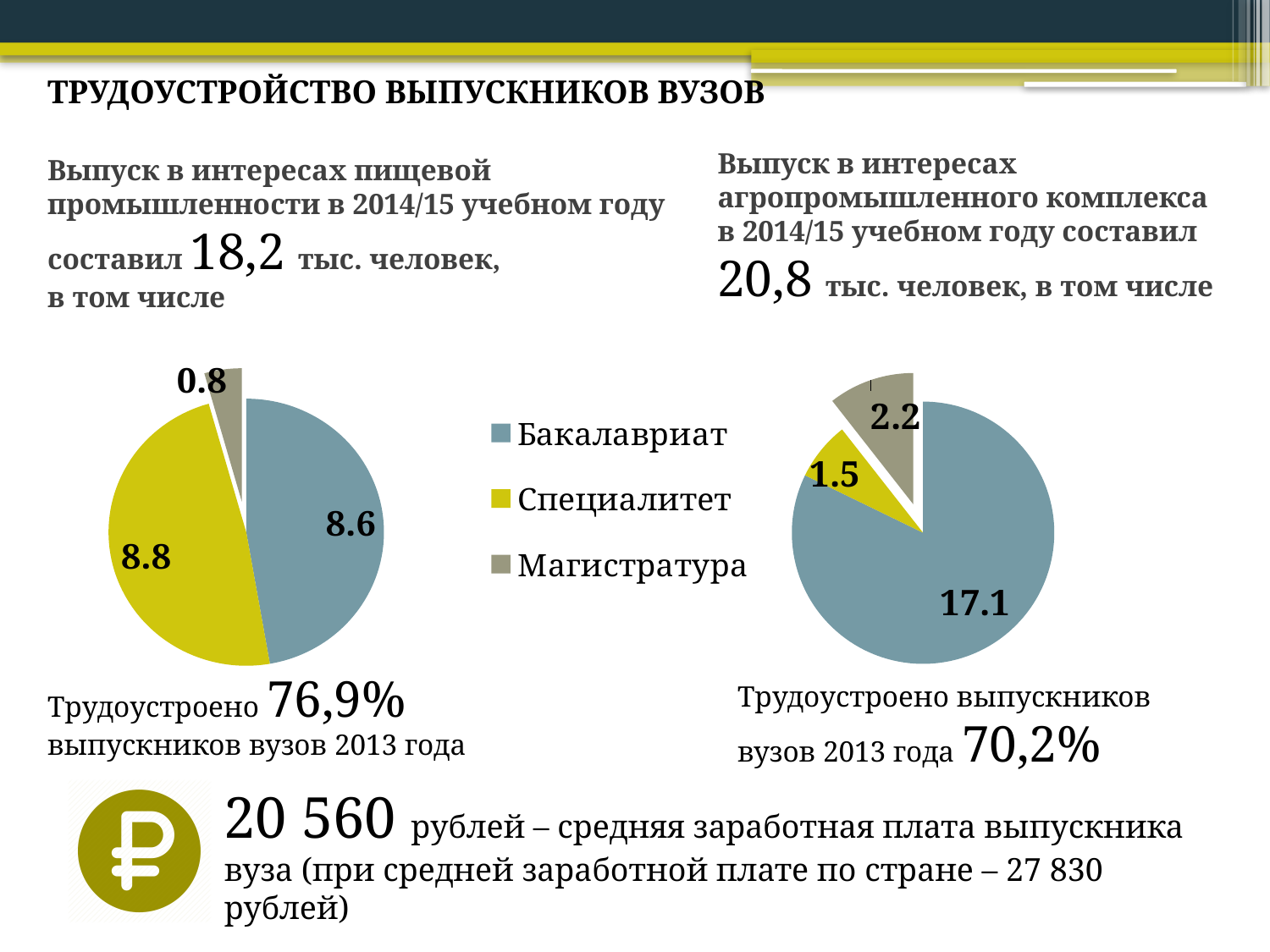
In the right pie chart (agro-industrial complex), what is the difference between Бакалавриат and Специалитет? 15.6 In the right pie chart (agro-industrial complex), what is the value for Специалитет? 1.5 In the left pie chart (food industry), which category has the smallest value? Магистратура In the left pie chart (food industry), what is the value for Магистратура? 0.8 In the right pie chart (agro-industrial complex), what is the value for Бакалавриат? 17.1 How many slices does the left pie chart (food industry) have? 3 In the right pie chart (agro-industrial complex), which is larger: Магистратура or Специалитет? Магистратура In the left pie chart (food industry), what is the difference between Специалитет and Бакалавриат? 0.2 In the left pie chart (food industry), which category has the largest value? Специалитет In the left pie chart (food industry), what is the value for Бакалавриат? 8.6 What type of chart is used on this slide? Pie chart In the right pie chart (agro-industrial complex), which category has the smallest value? Специалитет